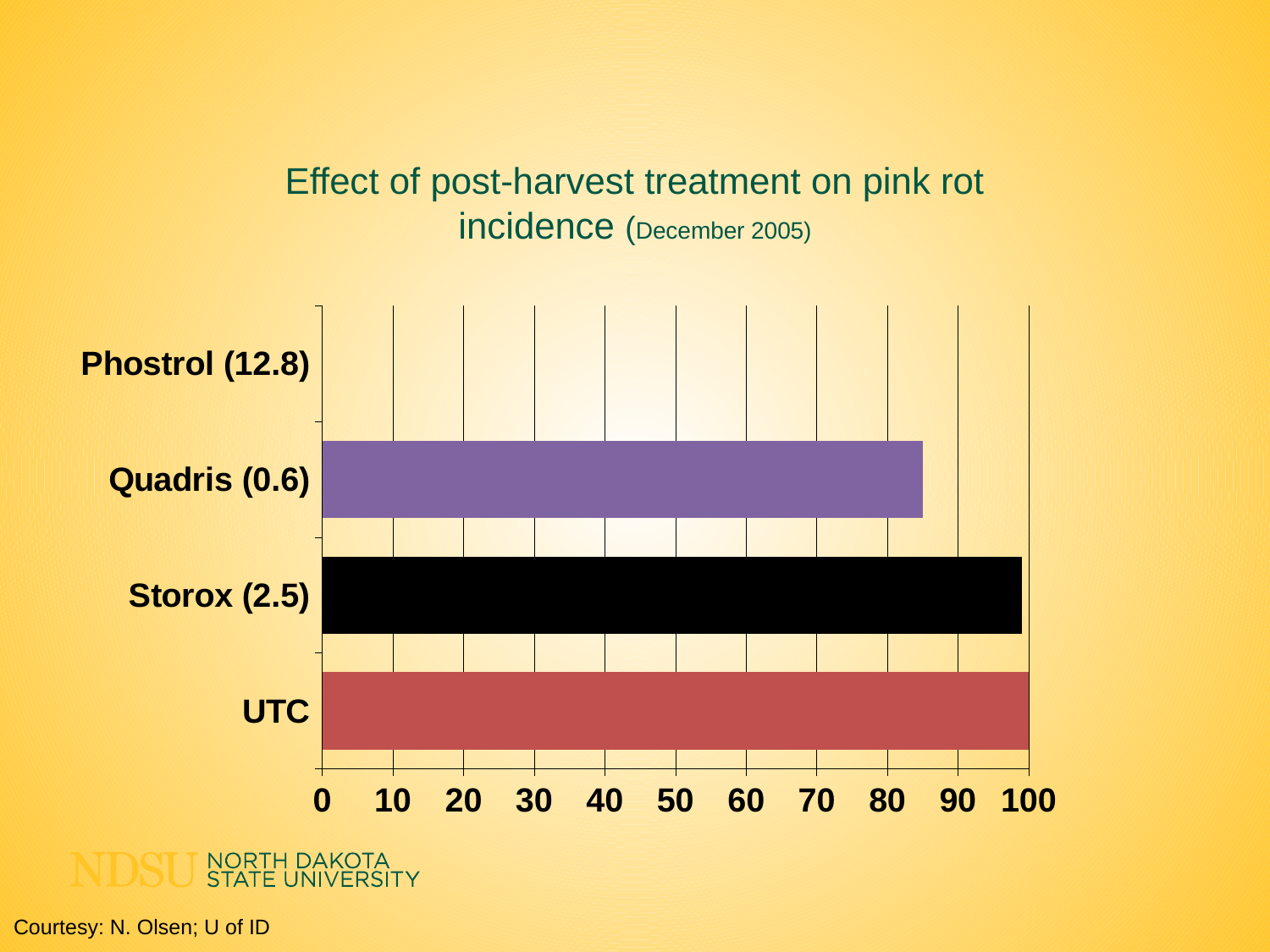
Is the value for Quadris (0.6) greater or less than 80? greater What is the title of the chart? Effect of post-harvest treatment on pink rot incidence (December 2005) Is the value for Phostrol (12.8) greater or less than 10? less Is the value for Storox (2.5) greater or less than 90? greater Which has the larger value, Quadris (0.6) or UTC? UTC How many treatment categories are plotted on the chart? 4 What colour is the bar for Storox (2.5)? black Which treatment has the lowest pink rot incidence on the chart? Phostrol (12.8) Which has the larger value, Quadris (0.6) or Storox (2.5)? Storox (2.5) What is the value for UTC on the chart? 100 What kind of chart is shown on the slide? bar chart